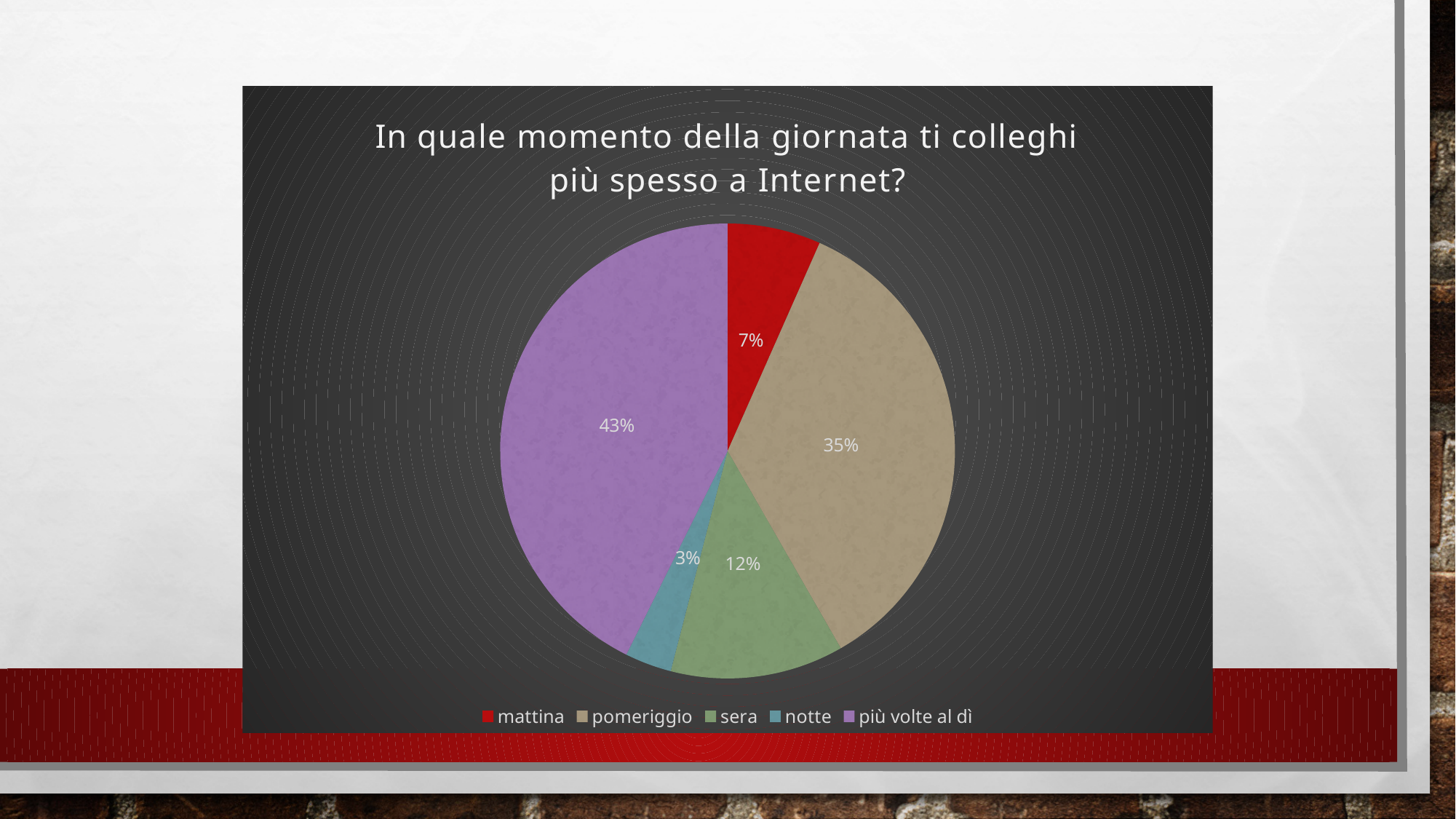
What percentage is shown for "più volte al dì"? 43% Which is larger, the share for "sera" or the share for "mattina"? sera What percentage is shown for "sera"? 12% What percentage is shown for "pomeriggio"? 35% What is the title of the chart? In quale momento della giornata ti colleghi più spesso a Internet? What is the difference in percentage points between "più volte al dì" and "pomeriggio"? 8 What type of chart is shown on the slide? pie chart What percentage is shown for "mattina"? 7% Which category has the smallest share of the pie? notte How many categories does the legend list? 5 What percentage is shown for "notte"? 3% Which category has the largest share of the pie? più volte al dì